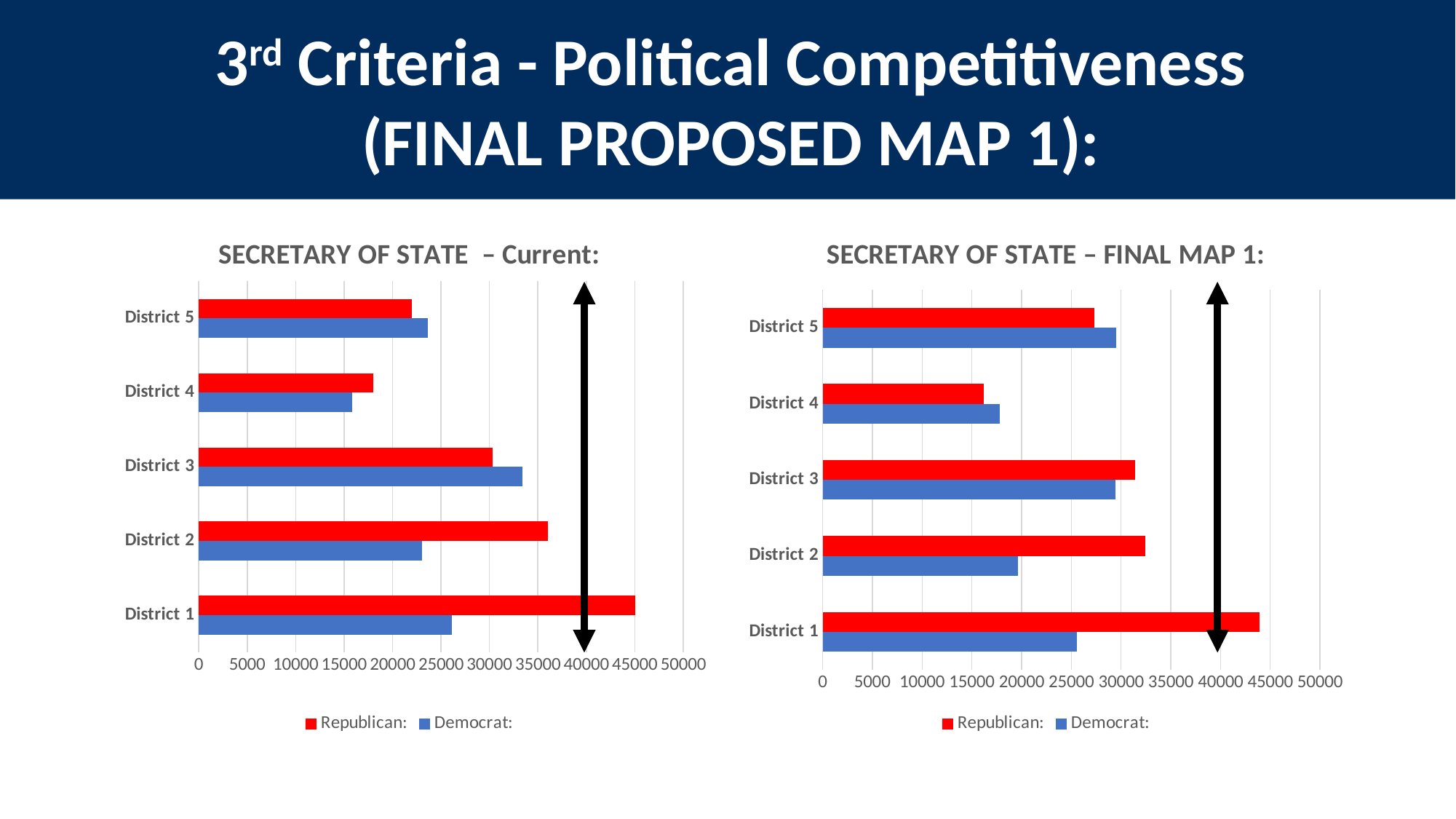
In the SECRETARY OF STATE – FINAL MAP 1 chart, is the Republican value for District 1 greater or less than 40000? greater In the SECRETARY OF STATE – Current chart, what colour represents the Democrat series? blue In the SECRETARY OF STATE – FINAL MAP 1 chart, is the Republican value for District 4 greater or less than 20000? less In the SECRETARY OF STATE – Current chart, which district has the lowest Republican value? District 4 How many districts are shown on the SECRETARY OF STATE – FINAL MAP 1 chart? 5 In the SECRETARY OF STATE – Current chart, for District 3, which is larger: the Republican or the Democrat value? Democrat In the SECRETARY OF STATE – Current chart, which district has the highest Republican value? District 1 In the SECRETARY OF STATE – Current chart, is the Republican value for District 1 greater or less than 40000? greater What type of chart is the SECRETARY OF STATE – Current chart? bar chart In the SECRETARY OF STATE – FINAL MAP 1 chart, for District 2, which is larger: the Republican or the Democrat value? Republican How many series does the legend of the SECRETARY OF STATE – Current chart list? 2 In the SECRETARY OF STATE – FINAL MAP 1 chart, which district has the highest Republican value? District 1